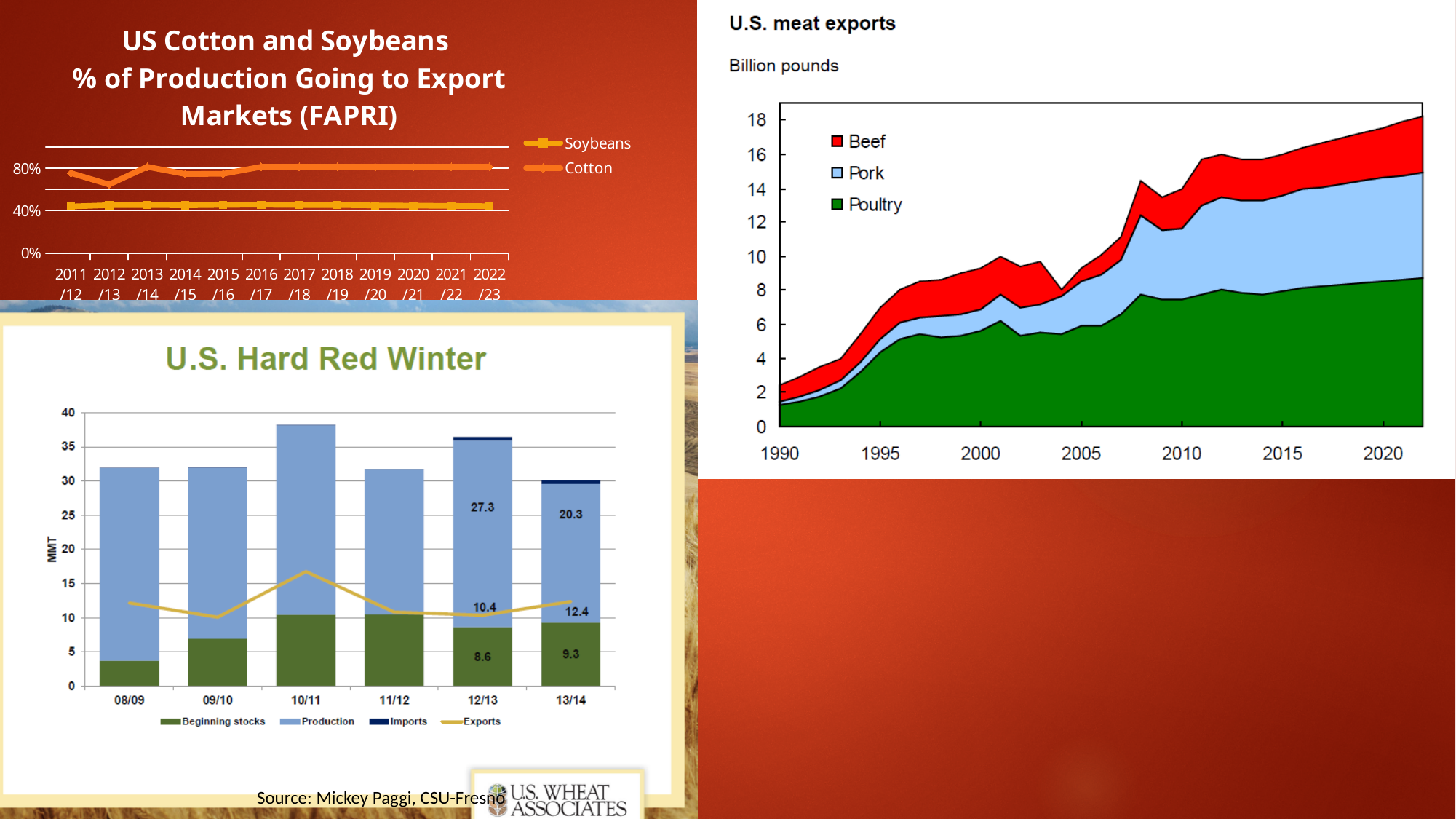
In the 'US Cotton and Soybeans' chart, how many series does the legend list? 2 What kind of chart is the 'U.S. meat exports' chart? Stacked area chart In the 'US Cotton and Soybeans' chart, is the Cotton value for 2012/13 greater or less than 40%? greater In the 'U.S. Hard Red Winter' chart, which year has the tallest stacked bar? 10/11 In the 'US Cotton and Soybeans' chart, which series has the higher values, Soybeans or Cotton? Cotton In the 'U.S. Hard Red Winter' chart, what is the difference between Production in 12/13 and Production in 13/14? 7.0 In the 'US Cotton and Soybeans' chart, how many marketing years are shown on the x axis? 12 In the 'U.S. Hard Red Winter' chart, what is the Production value for 12/13? 27.3 In the 'U.S. Hard Red Winter' chart, what is the Beginning stocks value for 13/14? 9.3 In the 'U.S. meat exports' chart, is the total value for 2020 greater or less than 16? greater In the 'U.S. Hard Red Winter' chart, what is the Exports value for 12/13? 10.4 In the 'U.S. Hard Red Winter' chart, how many series does the legend list? 4